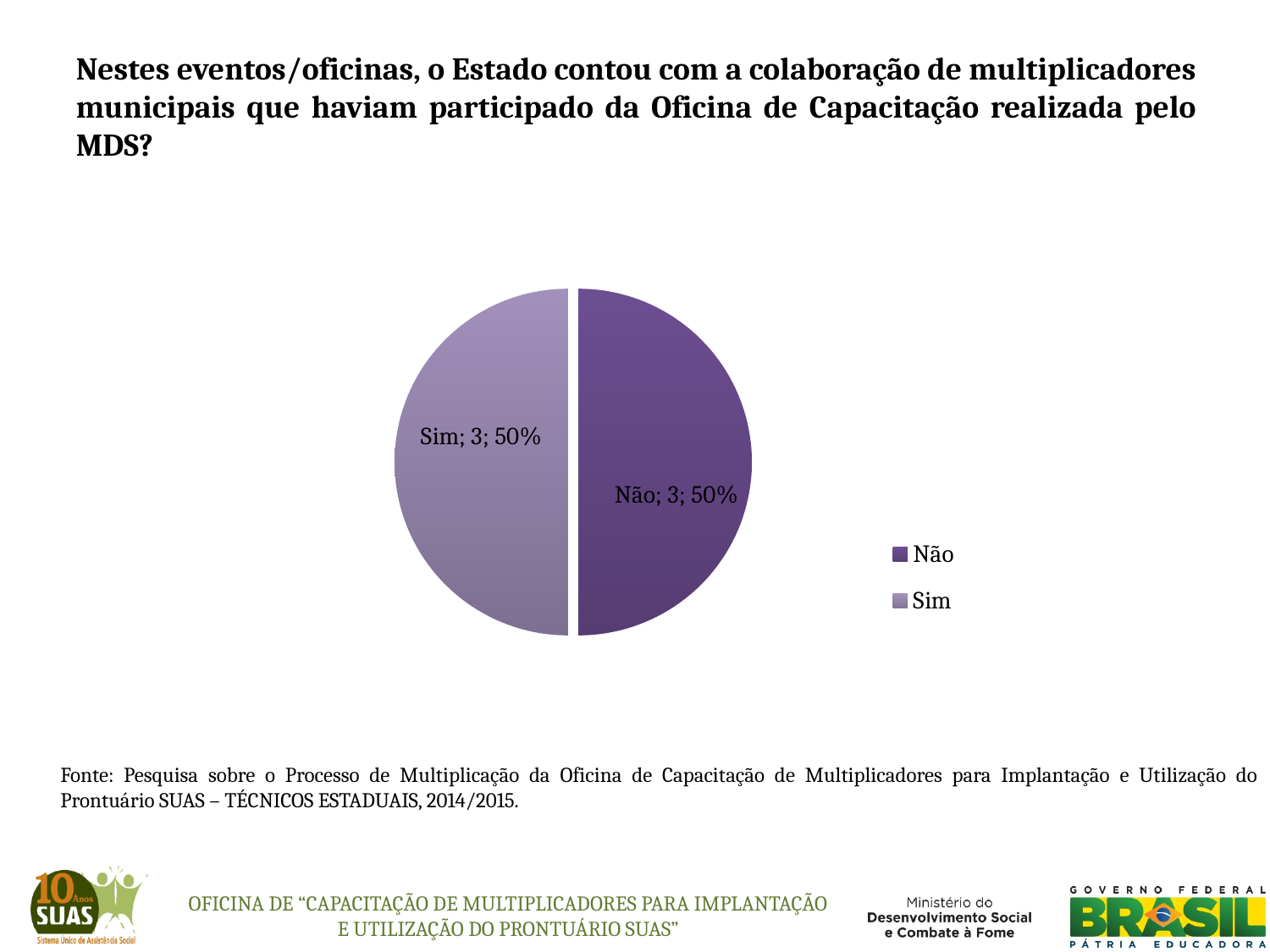
What kind of chart is shown on the slide? pie chart What is the total of the counts shown for all slices? 6 What is the count for the "Não" slice? 3 What is the count for the "Sim" slice? 3 Which slice is shown in the darker purple colour? Não What is the difference between the counts for "Não" and "Sim"? 0 What share of the pie does the "Não" slice represent? 50% What share of the pie does the "Sim" slice represent? 50% Which legend entry is listed first? Não How many slices does the pie chart have? 2 How many entries does the legend list? 2